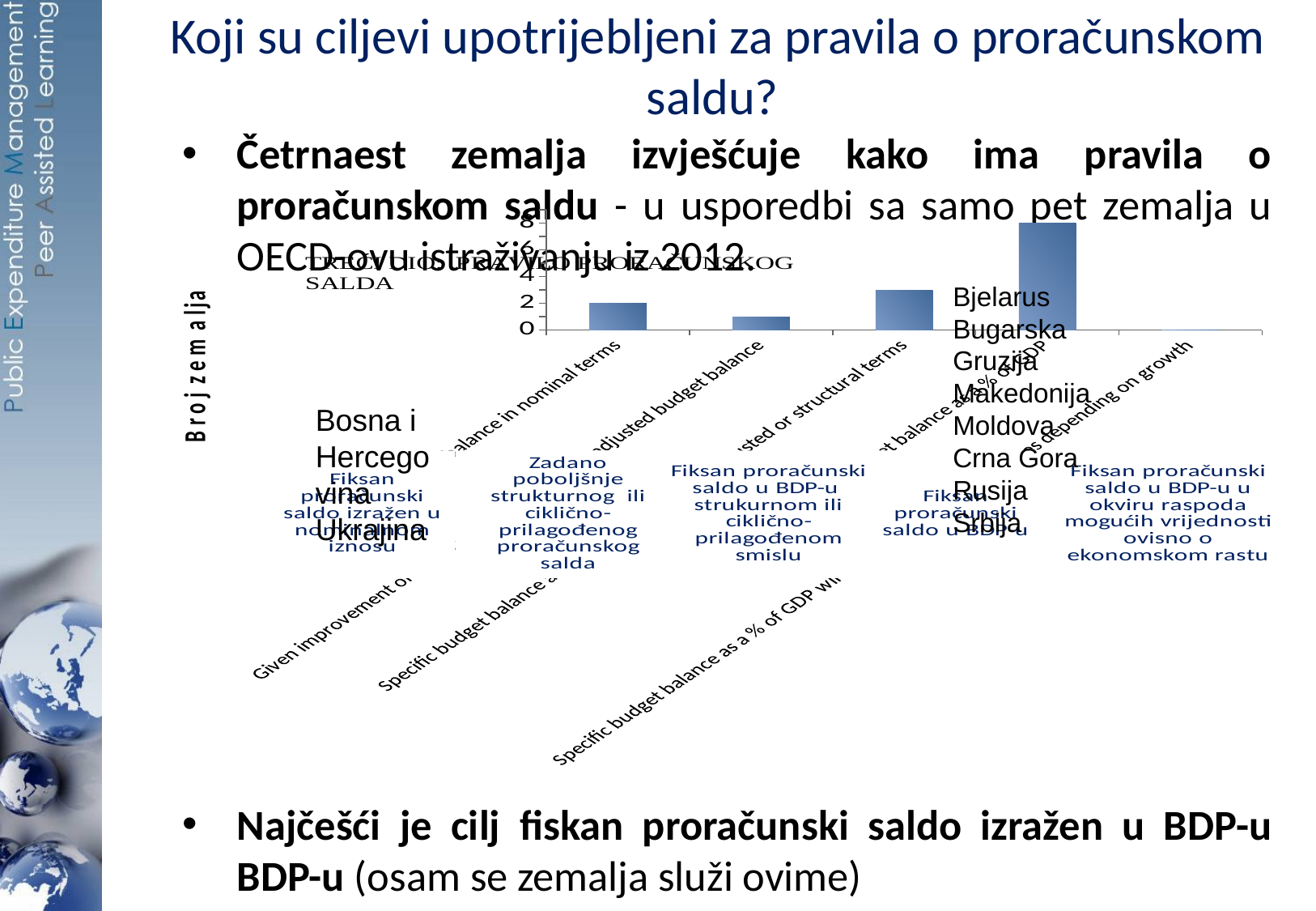
What kind of chart is shown on the slide? bar chart How many countries use the target 'Fiksan proračunski saldo u BDP-u'? 8 Which has more countries: 'Fiksan proračunski saldo izražen u nominalnom iznosu' or 'Zadano poboljšnje strukturnog ili ciklično-prilagođenog proračunskog salda'? Fiksan proračunski saldo izražen u nominalnom iznosu How many categories are labelled on the x axis of the chart? 5 Is the value for 'Fiksan proračunski saldo u BDP-u strukurnom ili ciklično-prilagođenom smislu' greater or less than 2? greater Is the value for 'Zadano poboljšnje strukturnog ili ciklično-prilagođenog proračunskog salda' greater or less than 2? less Which has more countries: 'Fiksan proračunski saldo izražen u nominalnom iznosu' or 'Fiksan proračunski saldo u BDP-u'? Fiksan proračunski saldo u BDP-u Which category has the highest number of countries? Fiksan proračunski saldo u BDP-u How many countries use the target 'Fiksan proračunski saldo izražen u nominalnom iznosu'? 2 What is the label of the vertical axis of the chart? Broj zemalja Is the value for 'Fiksan proračunski saldo u BDP-u' greater or less than 6? greater